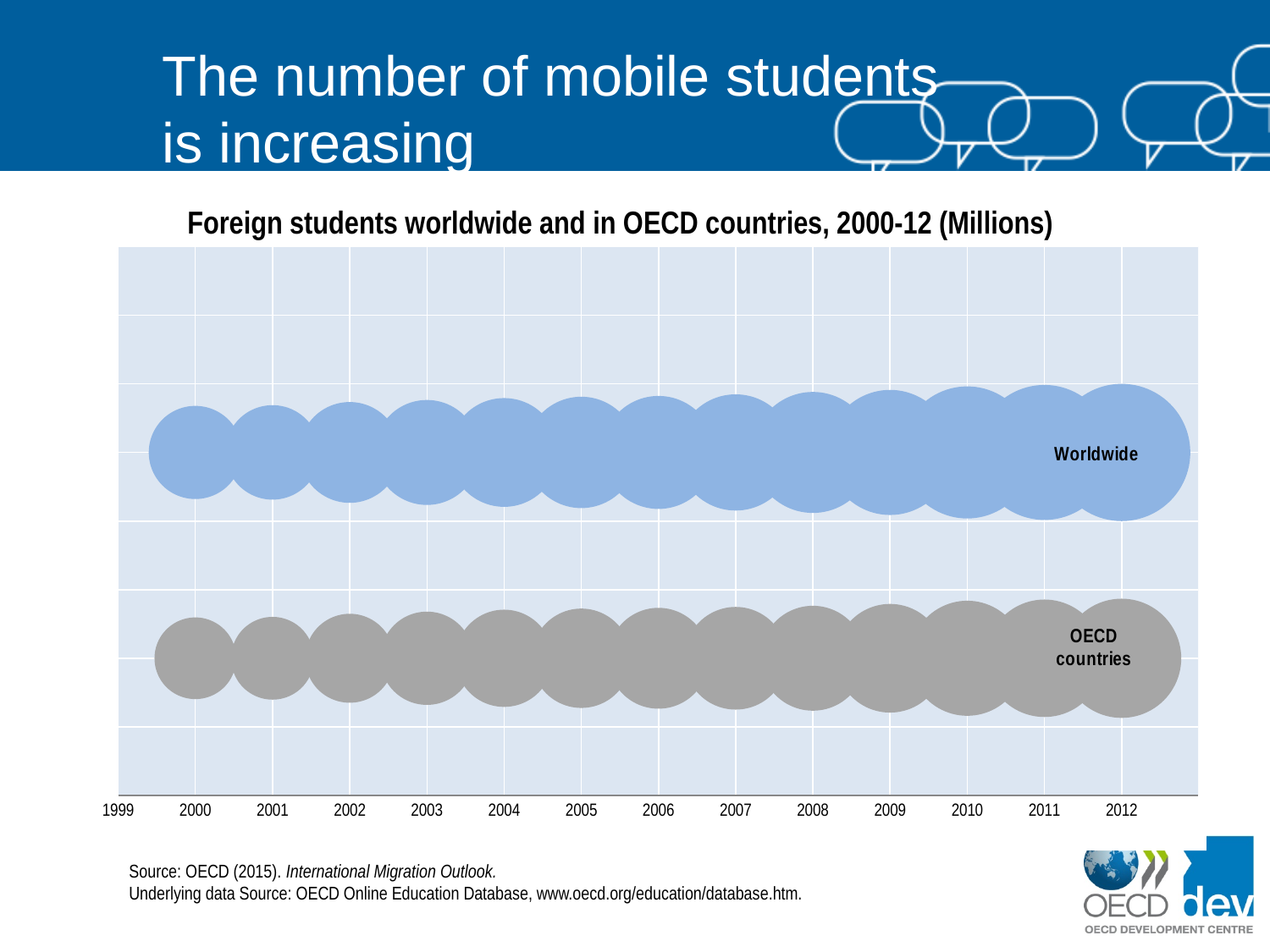
In 2000, which series has the larger bubble, Worldwide or OECD countries? Worldwide What is the title of the chart? Foreign students worldwide and in OECD countries, 2000-12 (Millions) In which year is the OECD countries bubble the largest? 2012 What kind of chart is shown on the slide? Bubble chart Do the bubble sizes for the OECD countries series rise or fall from 2000 to 2012? Rise In which year is the Worldwide bubble the smallest? 2000 In which year is the Worldwide bubble the largest? 2012 How many years have bubbles plotted for the Worldwide series? 13 Do the bubble sizes for the Worldwide series rise or fall from 2000 to 2012? Rise In 2012, which series has the larger bubble, Worldwide or OECD countries? Worldwide What are the names of the two series shown in the chart? Worldwide and OECD countries How many series are plotted in the chart? 2